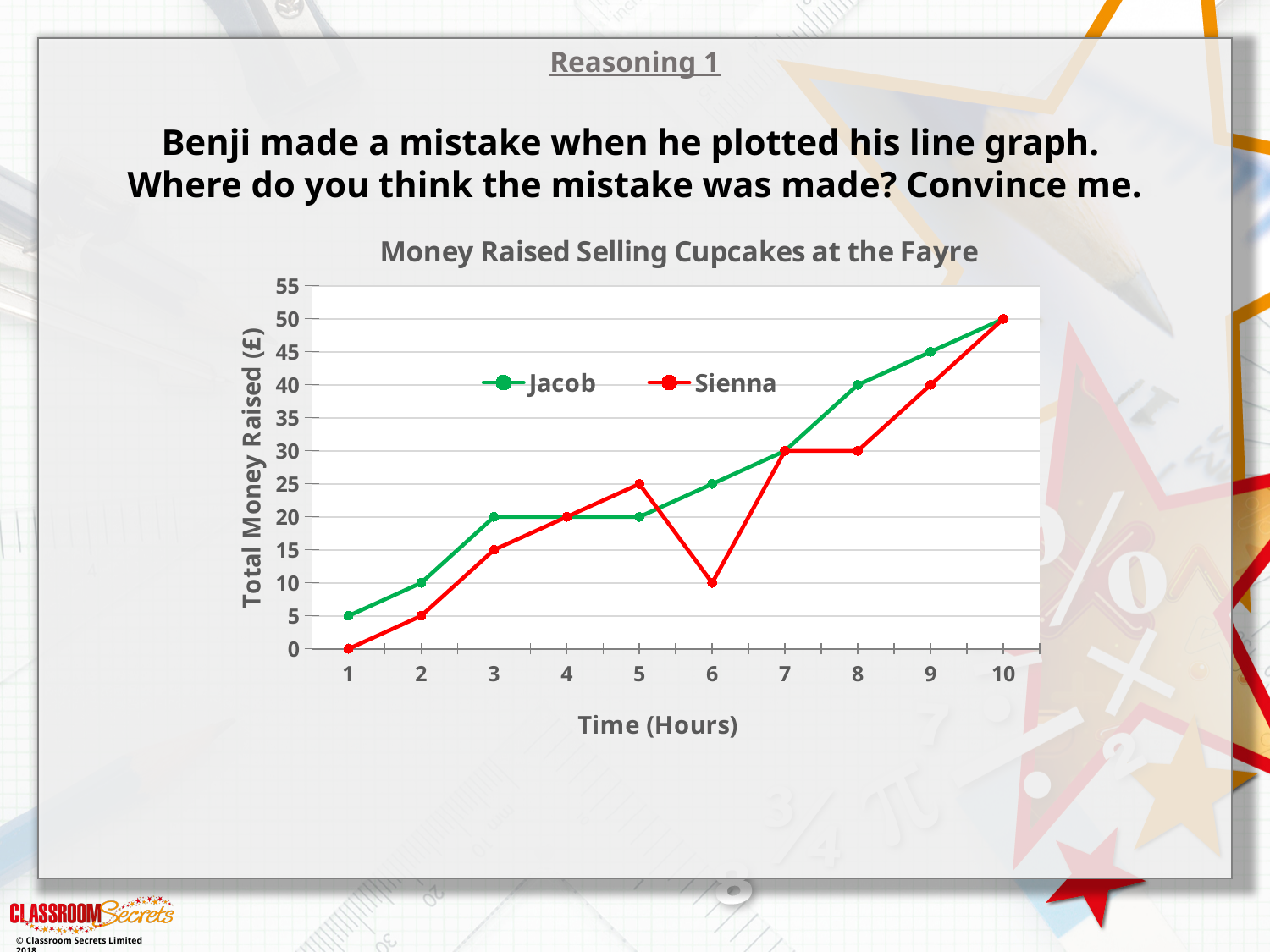
At 5 hours, who raised more money, Jacob or Sienna? Sienna Does Jacob's line generally rise or fall from 1 hour to 10 hours? rise How many time points are plotted along the x axis? 10 At which hour does Sienna's line reach its lowest value? 1 What is the total money raised by Sienna at 6 hours? 10 Which colour is used for Sienna's line? red How many series does the legend list? 2 What is the difference between Jacob's and Sienna's values at 6 hours? 15 What is the title of the chart? Money Raised Selling Cupcakes at the Fayre What kind of chart is shown on the slide? line chart What is the total money raised by Jacob at 3 hours? 20 What is the total money raised by Sienna at 1 hour? 0